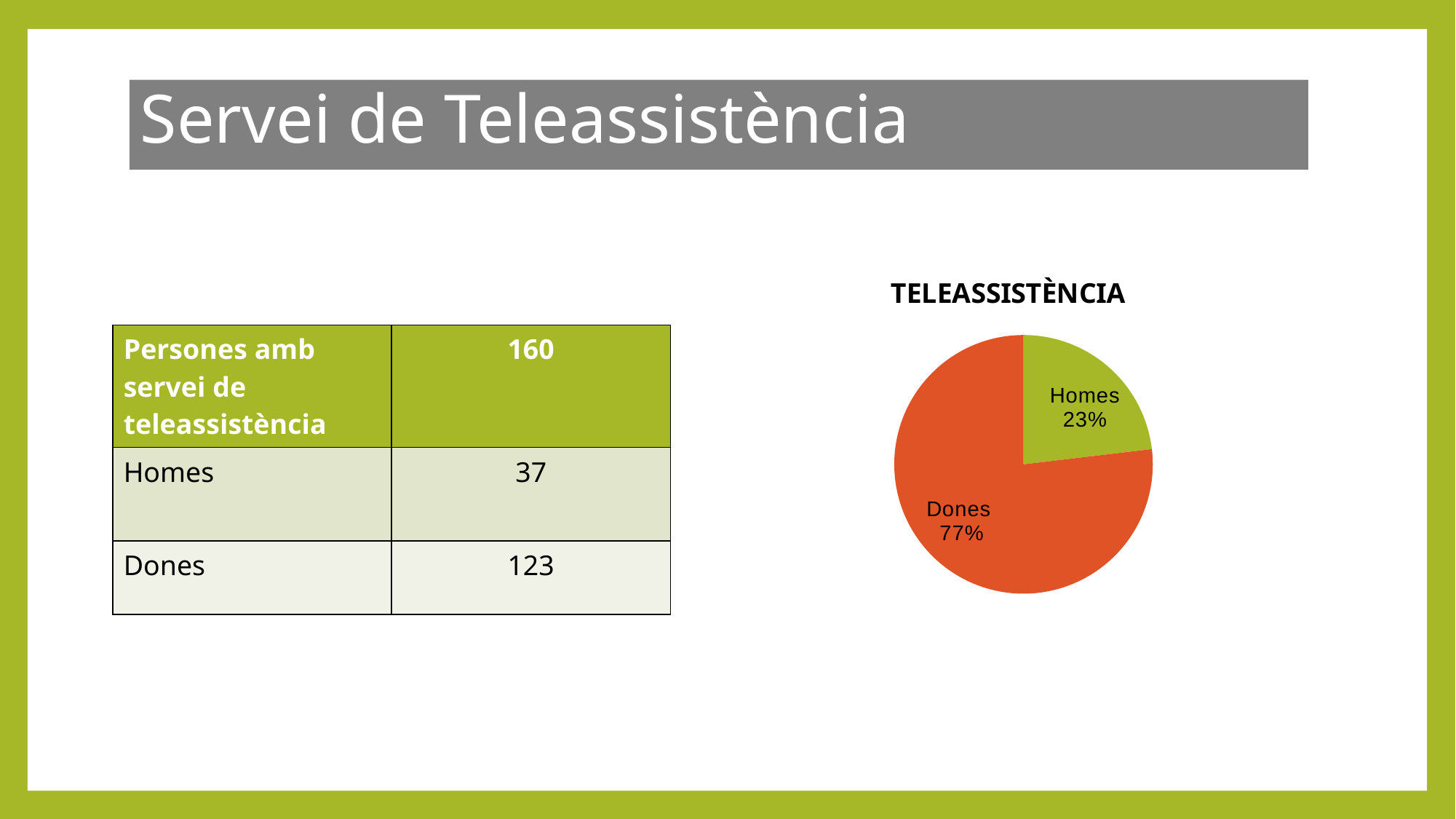
What colour is the Dones slice of the pie? orange-red Which slice of the pie is the smallest? Homes How many slices does the pie chart have? 2 Which slice of the pie is the largest? Dones What is the title of the chart? TELEASSISTÈNCIA What share of the pie does the Homes slice represent? 23% Is the share for Dones greater or less than 50%? greater What kind of chart is shown on the slide? pie chart What is the difference in percentage points between the Dones slice and the Homes slice? 54 What share of the pie does the Dones slice represent? 77% Which is larger, the Homes slice or the Dones slice? Dones